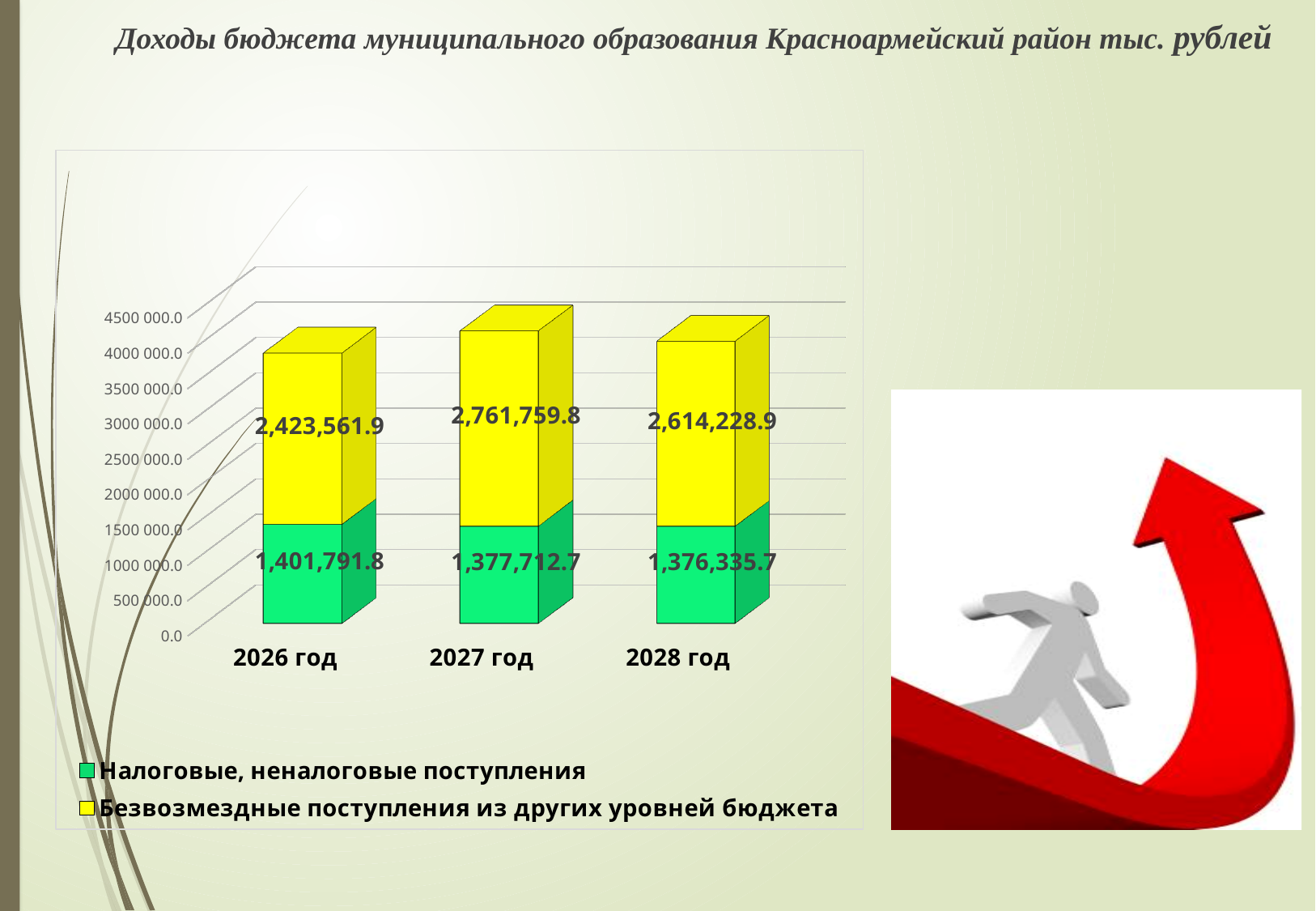
In which year is 'Безвозмездные поступления из других уровней бюджета' the lowest? 2026 год Which is larger: 'Налоговые, неналоговые поступления' in 2026 год or in 2027 год? 2026 год What type of chart is shown on the slide? Stacked bar chart What is the value of 'Безвозмездные поступления из других уровней бюджета' for 2026 год? 2,423,561.9 In which year is 'Безвозмездные поступления из других уровней бюджета' the highest? 2027 год Which colour represents 'Налоговые, неналоговые поступления' in the chart? Green What is the value of 'Налоговые, неналоговые поступления' for 2027 год? 1,377,712.7 How many series does the legend list? 2 How many years (categories) are shown on the x axis? 3 What is the difference between 'Безвозмездные поступления из других уровней бюджета' in 2027 год and 2026 год? 338,197.9 What is the total of the stacked bar for 2027 год? 4,139,472.5 What is the value of 'Налоговые, неналоговые поступления' for 2028 год? 1,376,335.7